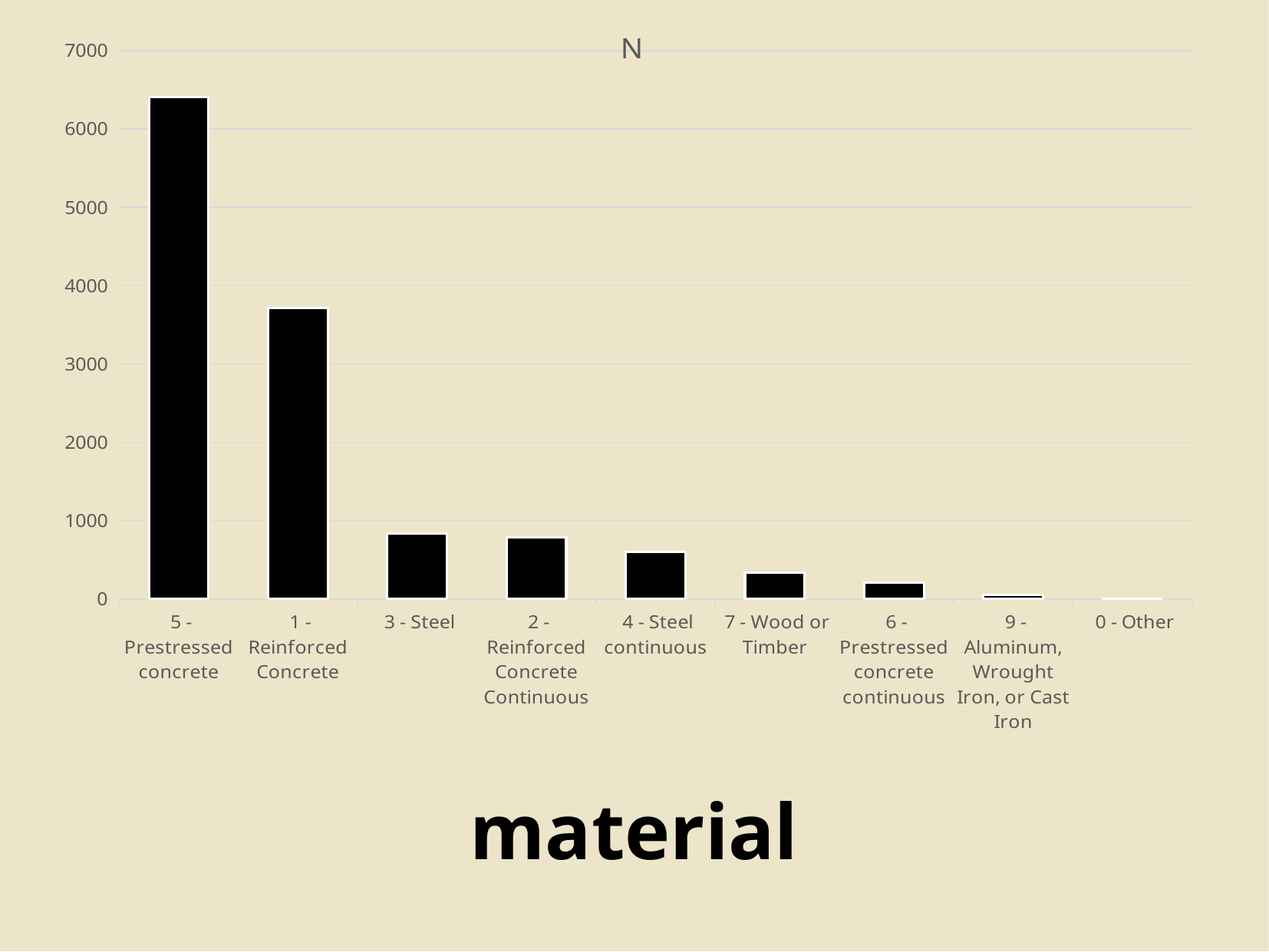
Which category has the highest value? 5 - Prestressed concrete Is the value for 3 - Steel greater or less than 1000? less Which is larger, the value for 1 - Reinforced Concrete or the value for 2 - Reinforced Concrete Continuous? 1 - Reinforced Concrete What is the title of the chart? N Is the value for 1 - Reinforced Concrete greater or less than 4000? less How many categories are shown on the x axis of the chart? 9 What kind of chart is shown on the slide? bar chart Is the value for 7 - Wood or Timber greater or less than 1000? less Which is larger, the value for 3 - Steel or the value for 4 - Steel continuous? 3 - Steel Do the bar values rise or fall from left to right along the x axis? fall Which category has the lowest value? 0 - Other